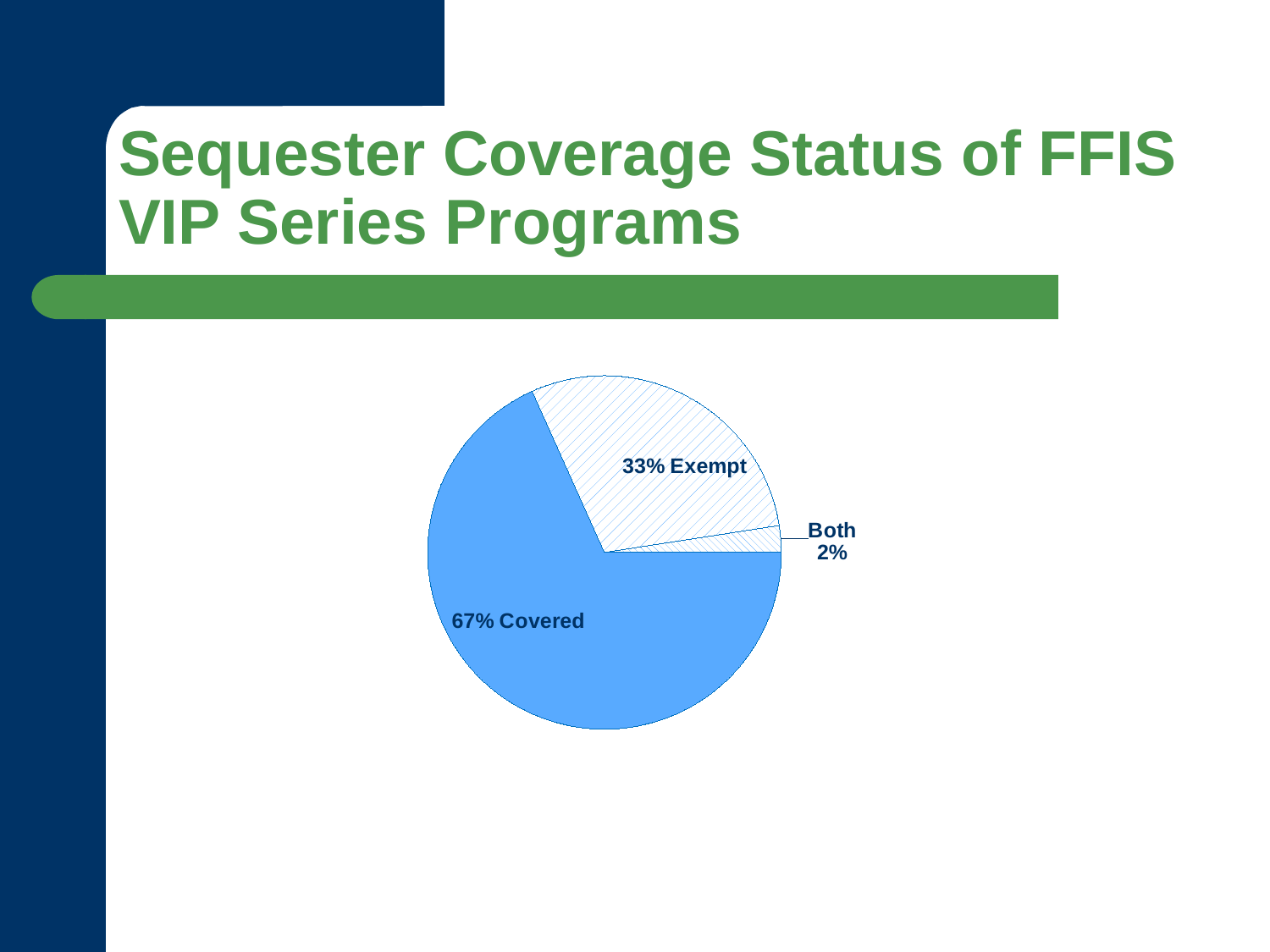
Which is larger, the Covered slice or the Exempt slice? Covered Which is larger, the Exempt slice or the Both slice? Exempt What kind of chart is shown on the slide? pie chart What share of the pie is labelled Exempt? 33% What is the difference in percentage points between the Exempt and Both slices? 31 What share of the pie is labelled Covered? 67% What share of the pie is labelled Both? 2% Which slice of the pie is the largest? Covered How many slices does the pie chart have? 3 What is the title of the slide containing the pie chart? Sequester Coverage Status of FFIS VIP Series Programs Which slice of the pie is the smallest? Both What is the difference in percentage points between the Covered and Exempt slices? 34